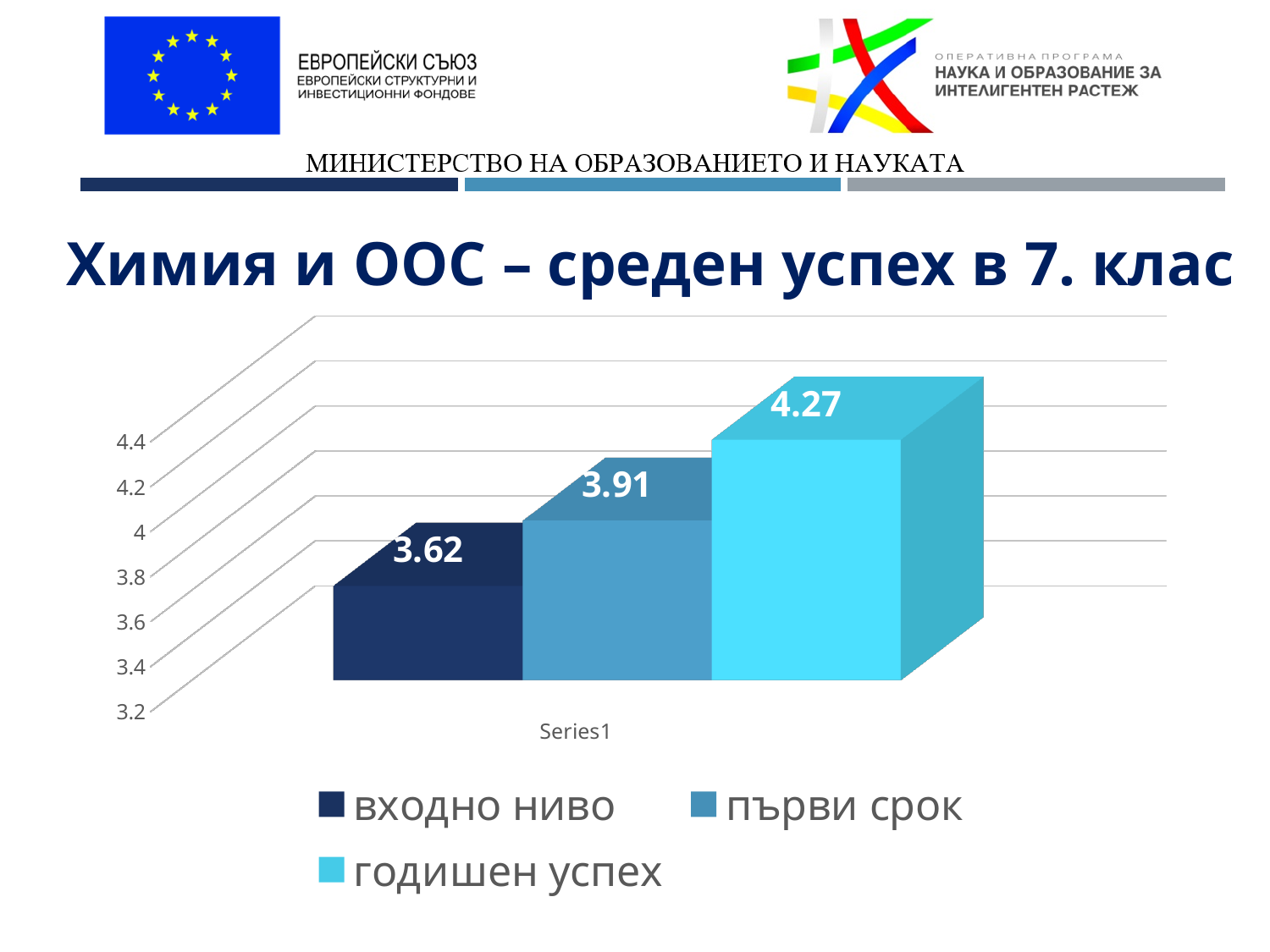
Which series has the lowest value? входно ниво What is the title of the chart? Химия и ООС – среден успех в 7. клас What kind of chart is shown on the slide? bar chart What is the value for първи срок? 3.91 Which series has the highest value? годишен успех What is the difference between годишен успех and входно ниво? 0.65 Do the values rise or fall from входно ниво to годишен успех? rise How many series does the legend list? 3 What is the value for годишен успех? 4.27 What is the difference between първи срок and входно ниво? 0.29 What is the value for входно ниво? 3.62 Which is larger, първи срок or годишен успех? годишен успех